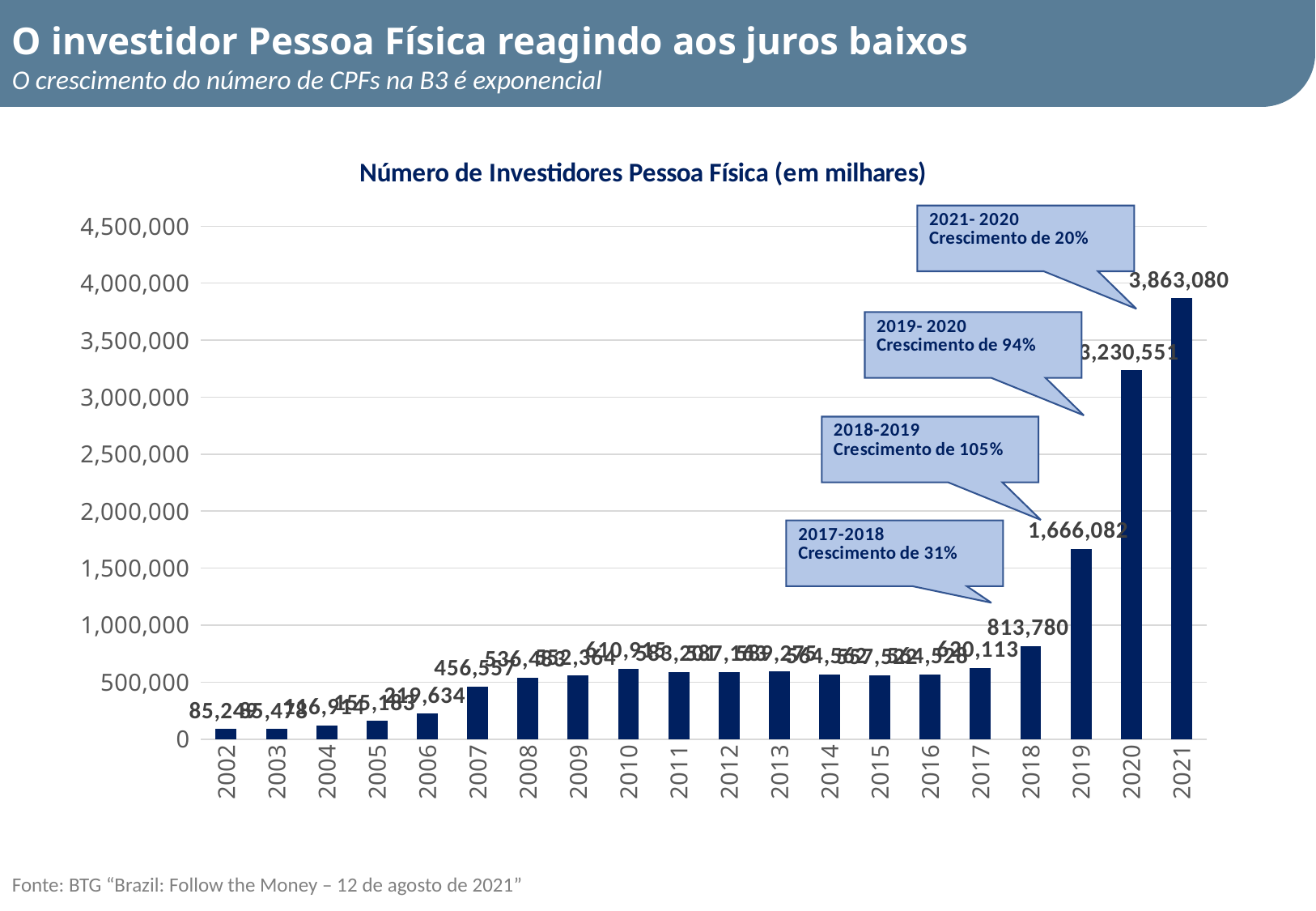
What is the value shown for 2002? 85,249 Which year has the lowest number of investors? 2002 How many years (bars) are plotted in the chart? 20 What is the value shown for 2021? 3,863,080 What is the value shown for 2019? 1,666,082 Which year has the highest number of investors? 2021 What is the value shown for 2020? 3,230,551 What is the value shown for 2018? 813,780 According to the callout, what was the growth from 2019 to 2020? 94% What kind of chart is shown on the slide? bar chart What is the difference between the values for 2021 and 2020? 632,529 Is the value for 2010 greater or less than 1,000,000? less